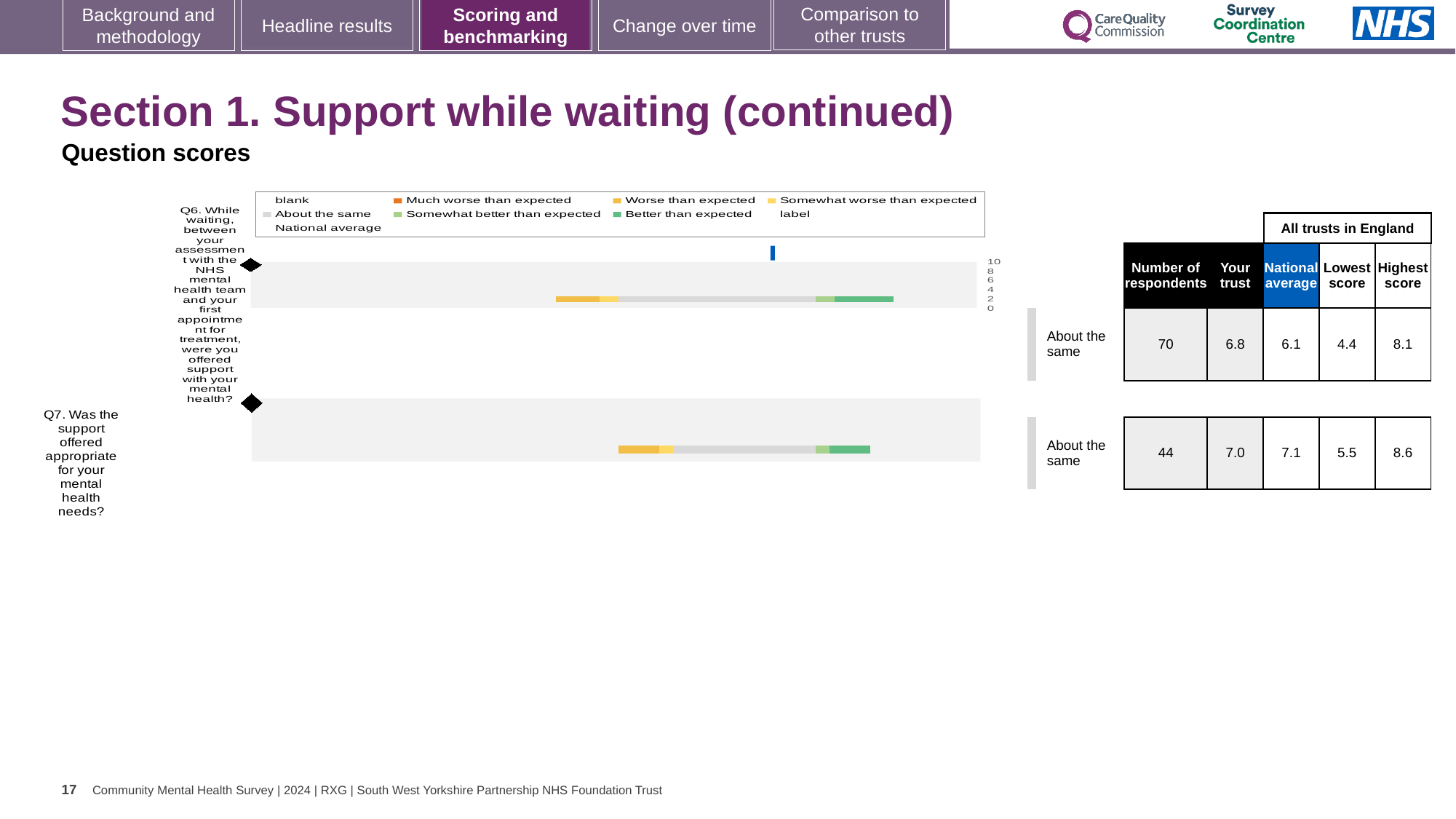
What is the 'Your trust' score for Q6? 6.8 What is the lowest score among all trusts in England for Q6? 4.4 What colour does the legend use for 'Better than expected'? green What type of chart is used to show the question scores on this slide? bar chart What benchmark category is shown for Q7? About the same For Q6, which is higher: the 'Your trust' score or the national average? Your trust What is the difference between the highest and lowest scores for Q7? 3.1 What is the national average score for Q7? 7.1 Which question has the higher 'Your trust' score, Q6 or Q7? Q7 By how much does the 'Your trust' score for Q6 exceed the national average? 0.7 How many questions are plotted in the chart? 2 How many respondents answered Q6? 70